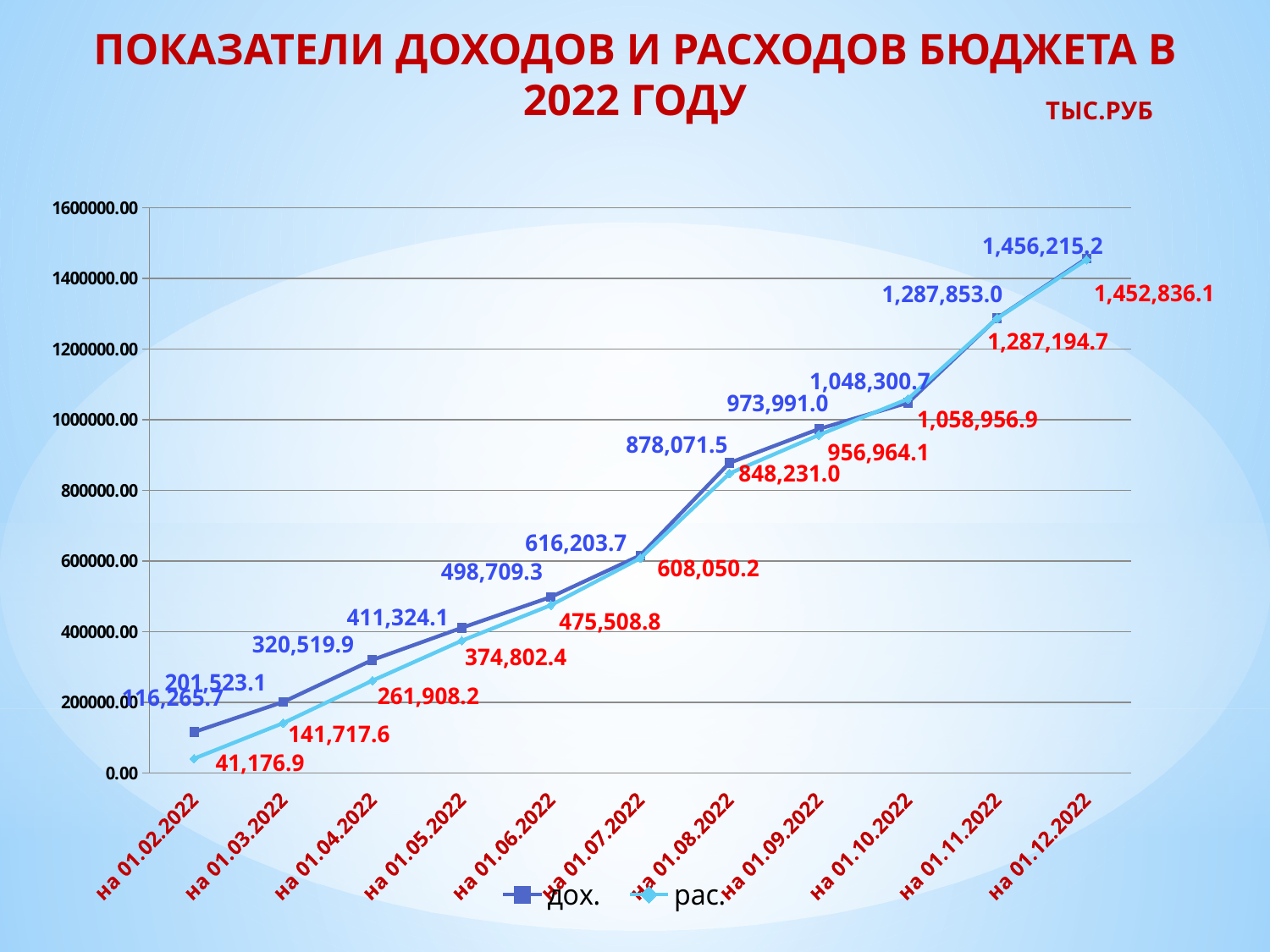
What is the value of the дох. series at на 01.12.2022? 1,456,215.2 How many dates are plotted along the x axis? 11 At which date is the дох. series highest? на 01.12.2022 How many series does the legend list? 2 At which date is the рас. series lowest? на 01.02.2022 Do the values of the дох. series rise or fall from на 01.02.2022 to на 01.12.2022? rise What is the value of the рас. series at на 01.10.2022? 1,058,956.9 What is the value of the рас. series at на 01.07.2022? 608,050.2 What is the difference between the дох. and рас. values at на 01.02.2022? 75,088.8 Which series has the larger value at на 01.10.2022, дох. or рас.? рас. What type of chart is shown on the slide? line chart What is the value of the дох. series at на 01.02.2022? 116,265.7